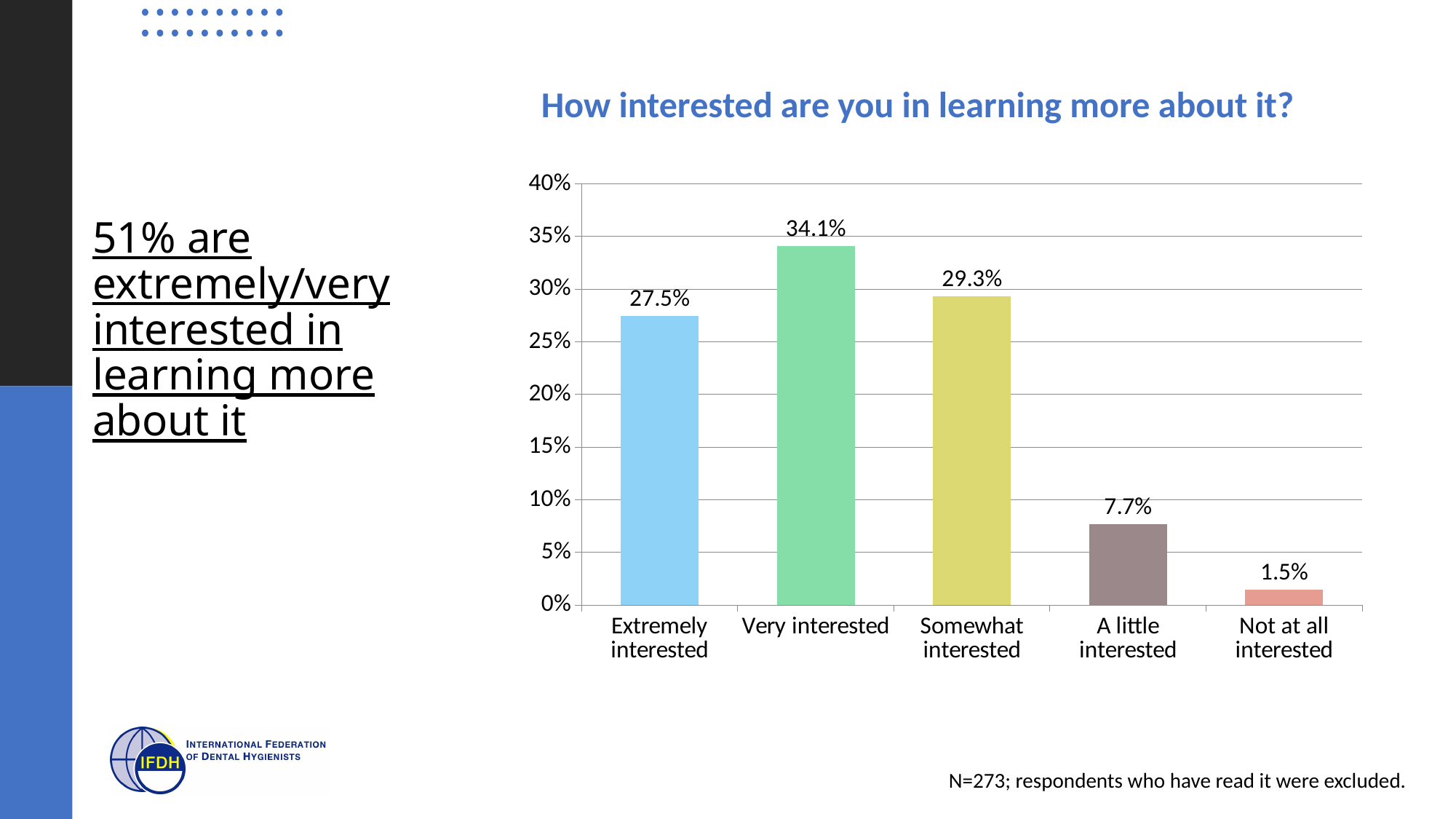
Which is larger, 'Somewhat interested' or 'Extremely interested'? Somewhat interested Which category has the lowest value? Not at all interested What kind of chart is shown on the slide? Bar chart What percentage of respondents are very interested in learning more about it? 34.1% What is the value for 'A little interested'? 7.7% How many categories are shown on the x axis? 5 Is the value for 'Extremely interested' greater or less than 25%? greater What is the title of the chart? How interested are you in learning more about it? What is the value for 'Not at all interested'? 1.5% What is the difference between 'Very interested' and 'Extremely interested'? 6.6% What is the difference between 'Somewhat interested' and 'A little interested'? 21.6% Which category has the highest value? Very interested